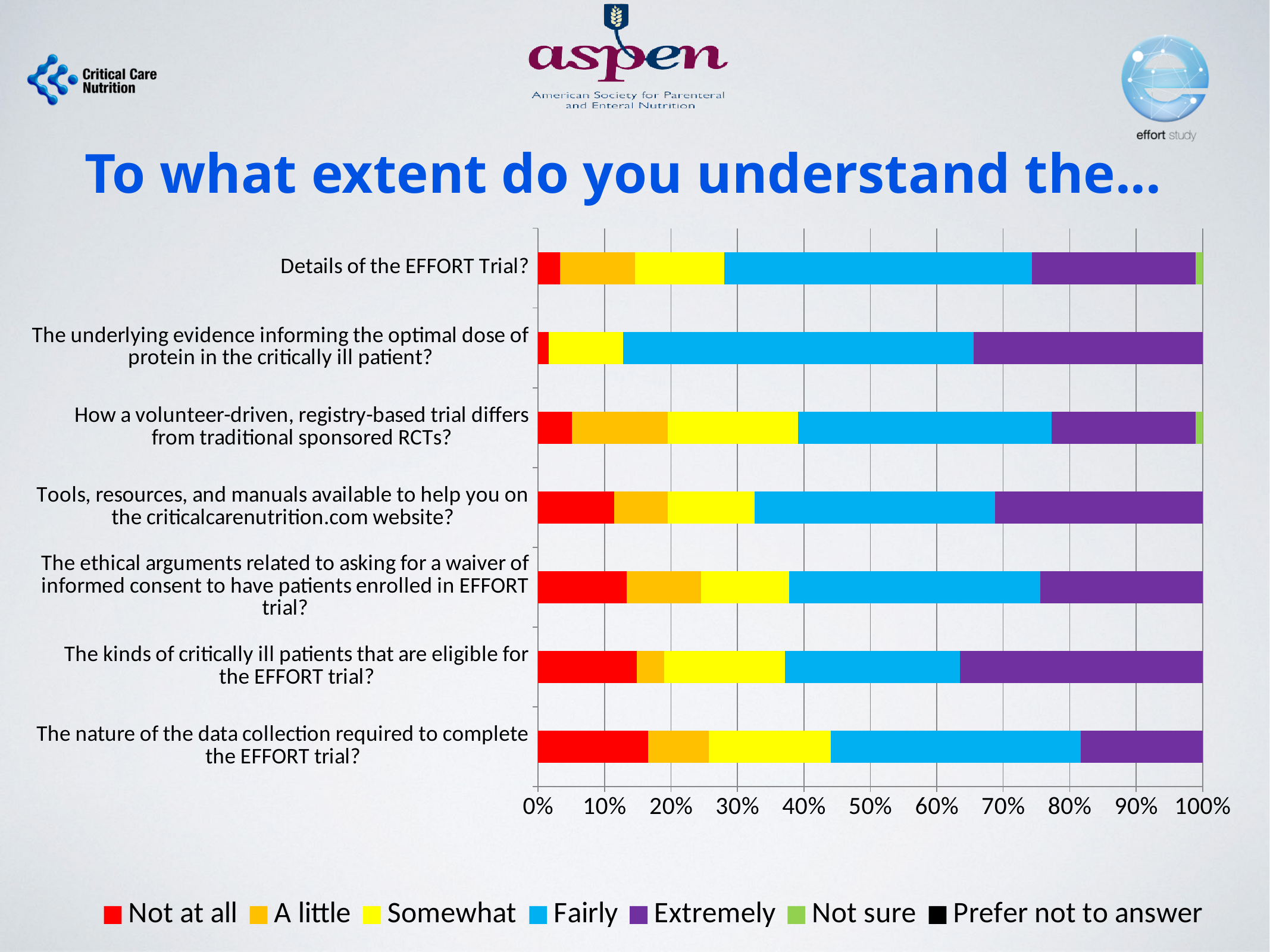
Which has the larger 'Not at all' share: 'The nature of the data collection required to complete the EFFORT trial?' or 'Details of the EFFORT Trial?'? The nature of the data collection required to complete the EFFORT trial? Which survey item has the largest 'Fairly' share? The underlying evidence informing the optimal dose of protein in the critically ill patient? Which colour represents the 'Extremely' response in the chart? Purple Which survey item has the smallest 'Not at all' share? The underlying evidence informing the optimal dose of protein in the critically ill patient? Which has the larger 'Extremely' share: 'The underlying evidence informing the optimal dose of protein in the critically ill patient?' or 'The nature of the data collection required to complete the EFFORT trial?'? The underlying evidence informing the optimal dose of protein in the critically ill patient? How many survey items (categories) are plotted in the chart? 7 Is the 'Not at all' share for 'Details of the EFFORT Trial?' greater or less than 10%? less What kind of chart is shown on the slide? Stacked bar chart Is the 'Extremely' share for 'The underlying evidence informing the optimal dose of protein in the critically ill patient?' greater or less than 30%? greater Is the 'Not at all' share for 'The nature of the data collection required to complete the EFFORT trial?' greater or less than 10%? greater What is the title of the chart on the slide? To what extent do you understand the… How many response options does the legend list? 7